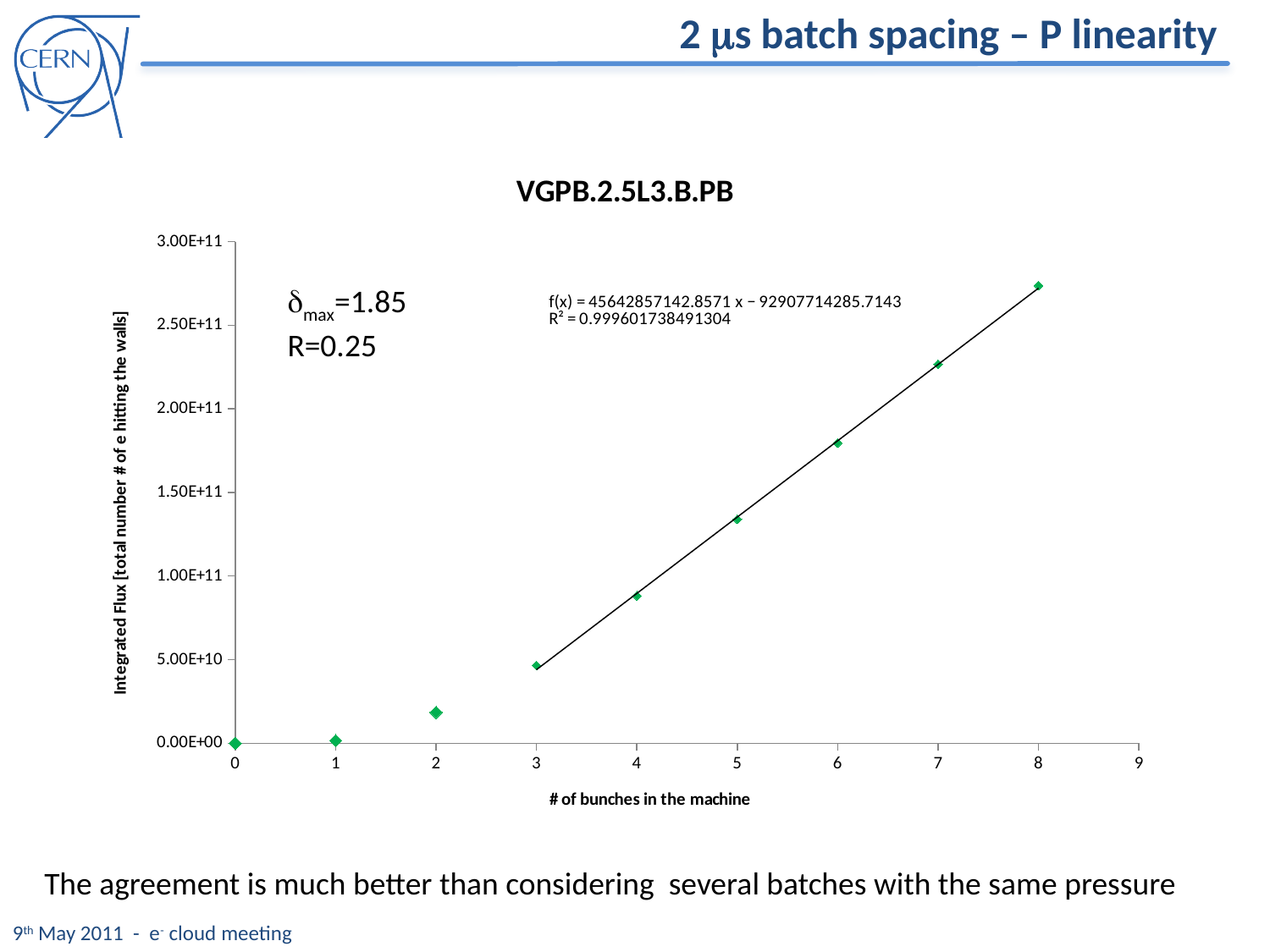
At which number of bunches is the integrated flux highest? 8 Which has the larger integrated flux, 7 bunches or 8 bunches? 8 bunches Is the integrated flux for 8 bunches greater or less than 2.50E+11? greater How many data points are plotted on the chart? 9 What kind of chart is shown on the slide? scatter chart Do the plotted values rise or fall as the number of bunches in the machine increases? rise What is the label of the x axis of the chart? # of bunches in the machine What is the title of the chart? VGPB.2.5L3.B.PB Is the integrated flux for 6 bunches greater or less than 1.50E+11? greater Is the integrated flux for 4 bunches greater or less than 1.00E+11? less At which number of bunches is the integrated flux lowest? 0